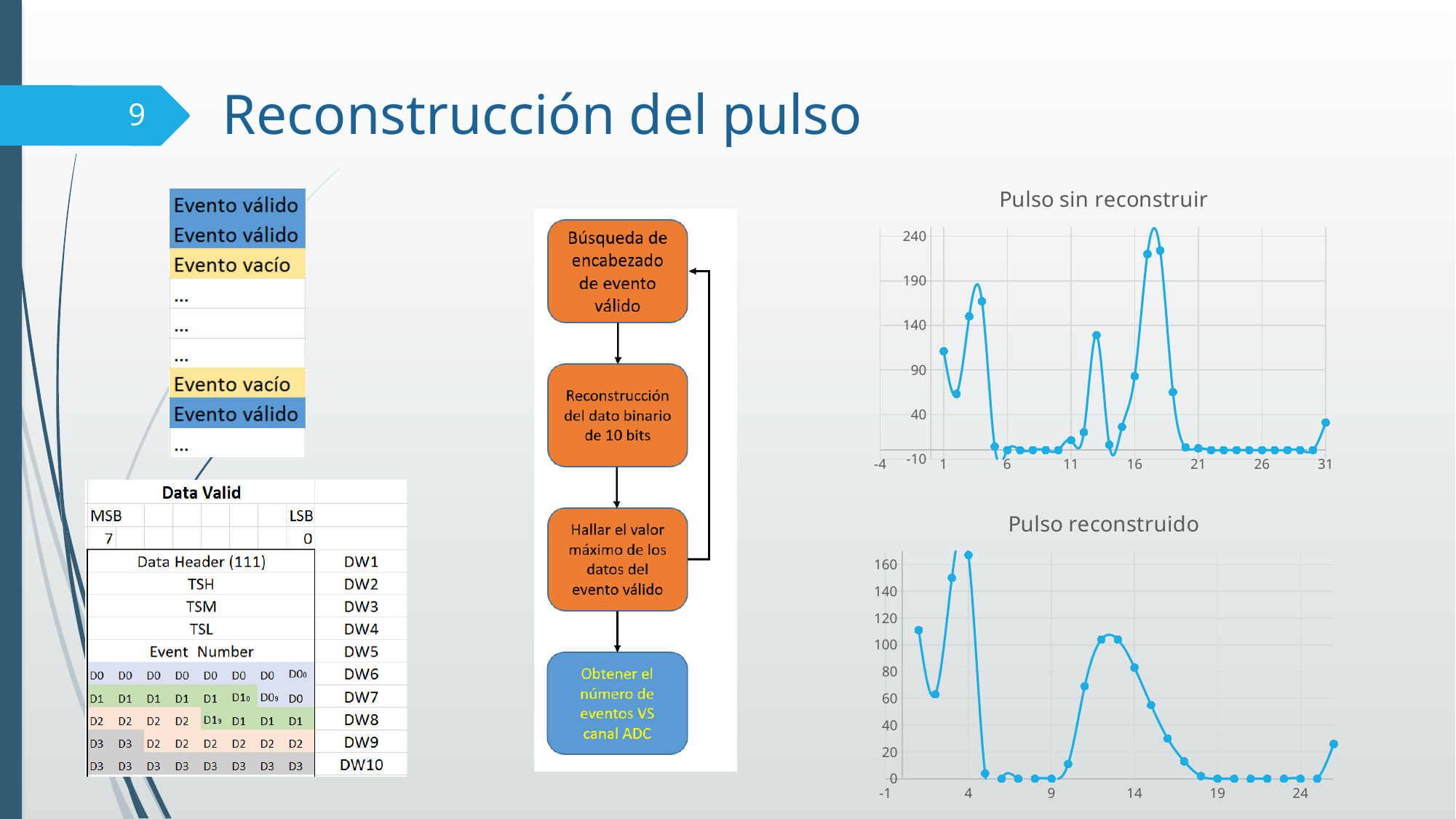
In the 'Pulso reconstruido' chart, is the value at x = 4 greater or less than 160? greater In the 'Pulso sin reconstruir' chart, which is larger, the value at x = 4 or the value at x = 13? x = 4 What kind of chart is the 'Pulso sin reconstruir' chart? line chart In the 'Pulso sin reconstruir' chart, is the value at x = 13 greater or less than 90? greater In the 'Pulso sin reconstruir' chart, is the value at x = 4 greater or less than 140? greater In the 'Pulso sin reconstruir' chart, which of the three peaks is the highest: the one near x = 4, near x = 13, or near x = 18? near x = 18 What kind of chart is the 'Pulso reconstruido' chart? line chart In the 'Pulso reconstruido' chart, do the values rise or fall between x = 14 and x = 19? fall What is the title of the lower chart on the right side of the slide? Pulso reconstruido What is the title of the upper chart on the right side of the slide? Pulso sin reconstruir